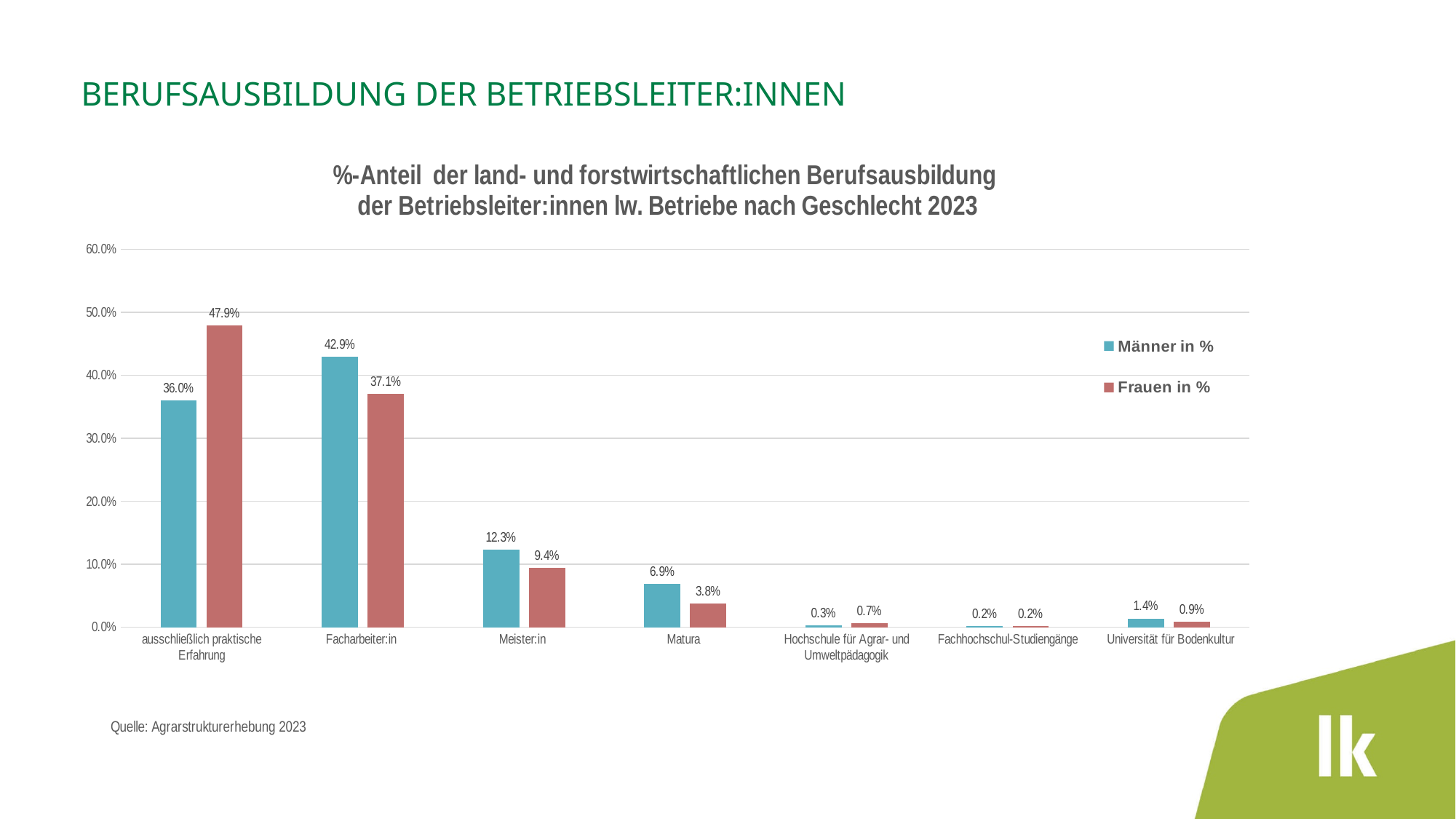
What is the value for Männer in % for Facharbeiter:in? 42.9% How many categories are shown on the x axis? 7 Which is larger for Universität für Bodenkultur: Männer in % or Frauen in %? Männer in % Which category has the highest value for Männer in %? Facharbeiter:in What is the source cited below the chart? Agrarstrukturerhebung 2023 What is the difference between the Männer in % and Frauen in % values for Meister:in? 2.9% How many series does the legend list? 2 What kind of chart is shown on the slide? bar chart Which category has the highest value for Frauen in %? ausschließlich praktische Erfahrung What is the value for Frauen in % for ausschließlich praktische Erfahrung? 47.9% Is the value for Männer in % for ausschließlich praktische Erfahrung greater or less than 40.0%? less What is the value for Frauen in % for Matura? 3.8%